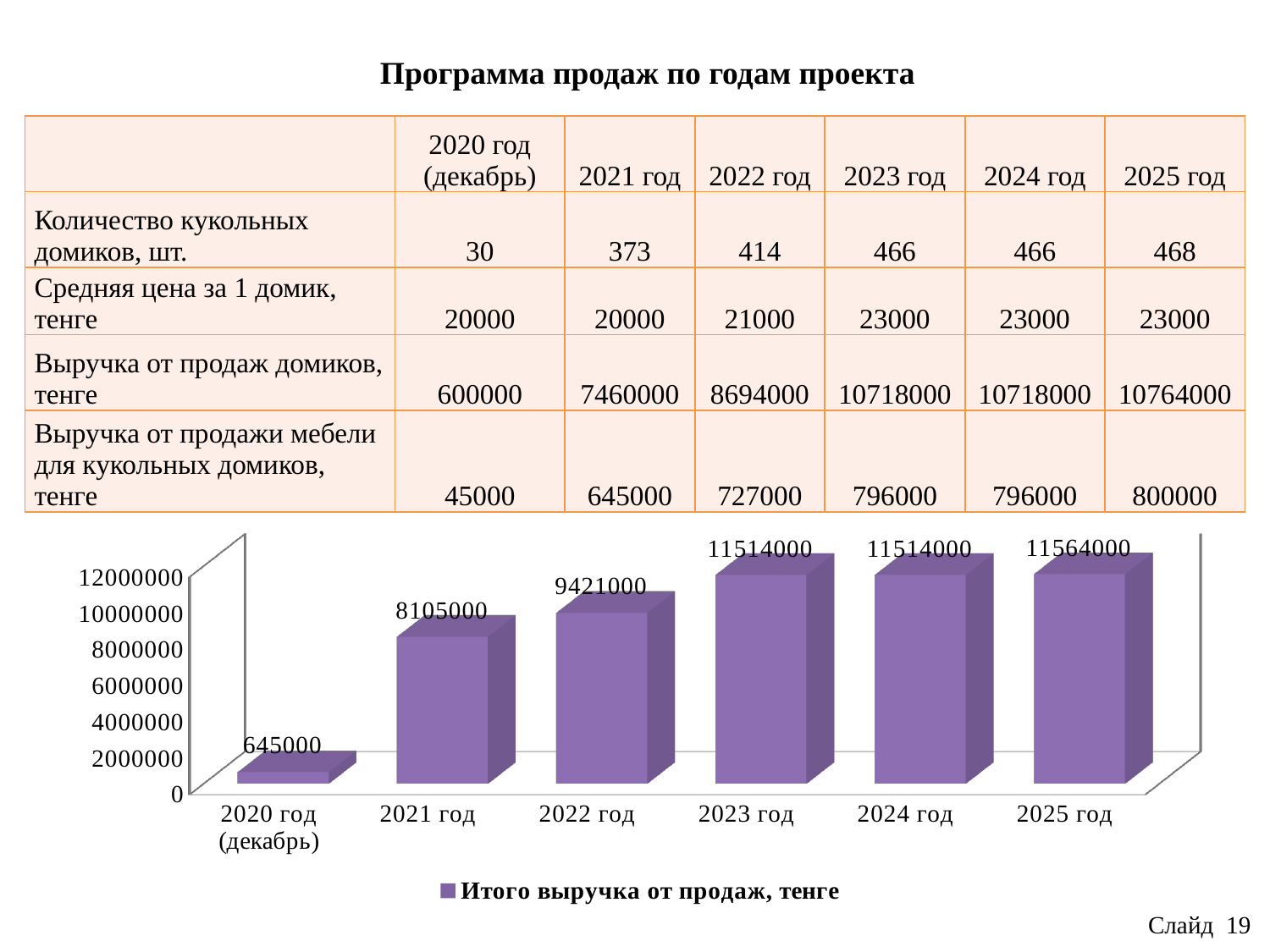
What is the value for 2021 год in the chart? 8105000 Which category has the highest value in the chart? 2025 год What is the legend entry of the chart? Итого выручка от продаж, тенге What is the difference between the values for 2022 год and 2021 год? 1316000 How many series does the chart legend list? 1 Which category has the lowest value in the chart? 2020 год (декабрь) Which is larger, the value for 2023 год or the value for 2022 год? 2023 год What kind of chart is shown on the slide? bar chart What is the value for 2022 год in the chart? 9421000 Is the value for 2021 год greater or less than 10000000? less What is the value for 2025 год in the chart? 11564000 How many categories are shown on the x axis of the chart? 6